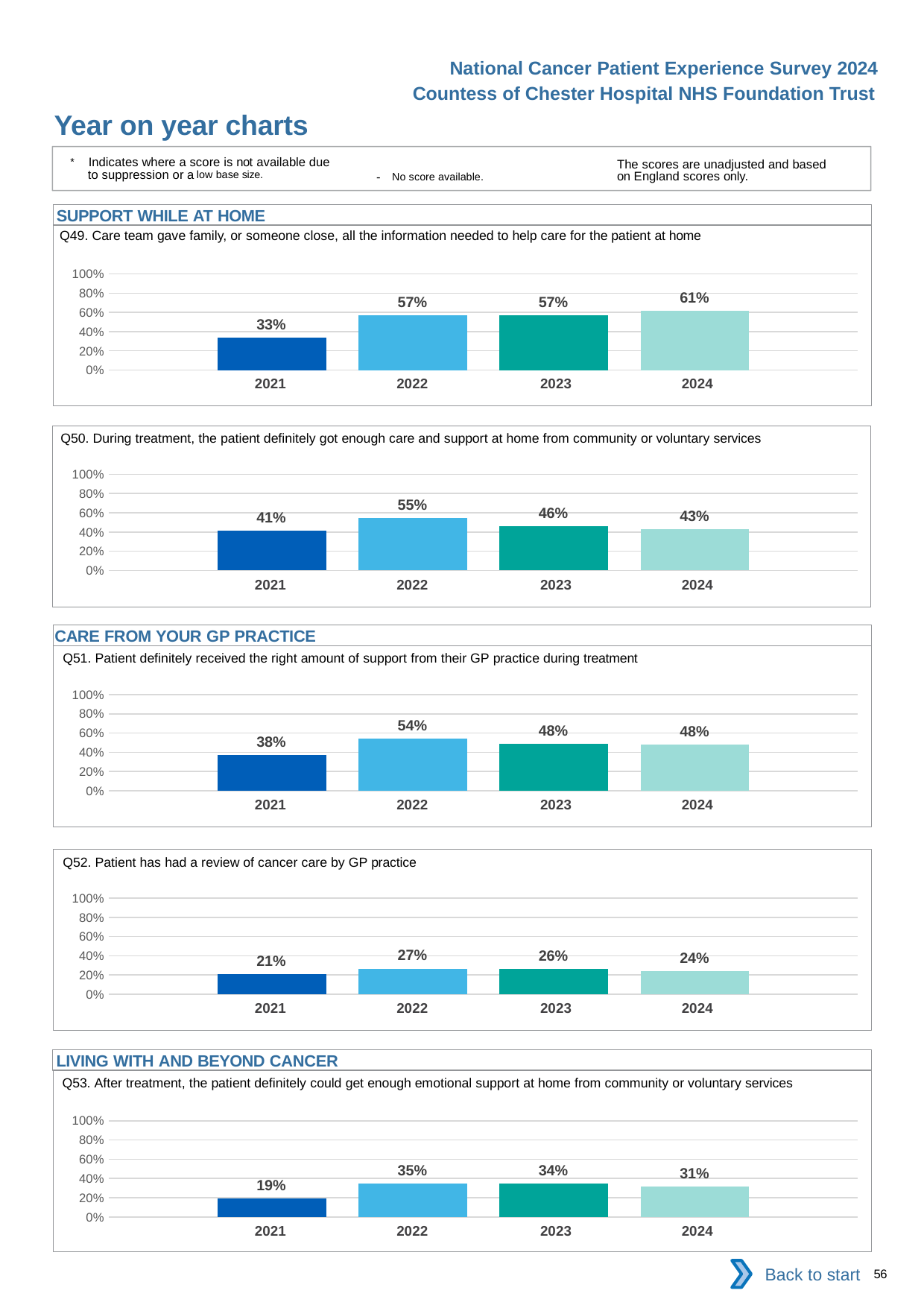
In the Q51 chart, what is the value for 2021? 38% In the Q50 chart, what is the difference between the 2022 and 2021 values? 14% In the Q52 chart, is the value for 2021 greater or less than 40%? less In the Q52 chart, what is the value for 2023? 26% In the Q53 chart, what is the difference between the 2022 and 2024 values? 4% In the Q49 chart, what is the value for 2024? 61% In the Q51 chart, which is larger, the value for 2022 or the value for 2023? 2022 In the Q49 chart, which year has the lowest value? 2021 How many years are shown on the x axis of the Q49 chart? 4 In the Q53 chart, do the values rise or fall from 2022 to 2024? fall In the Q50 chart, which year has the highest value? 2022 What kind of chart is the Q52 chart? bar chart